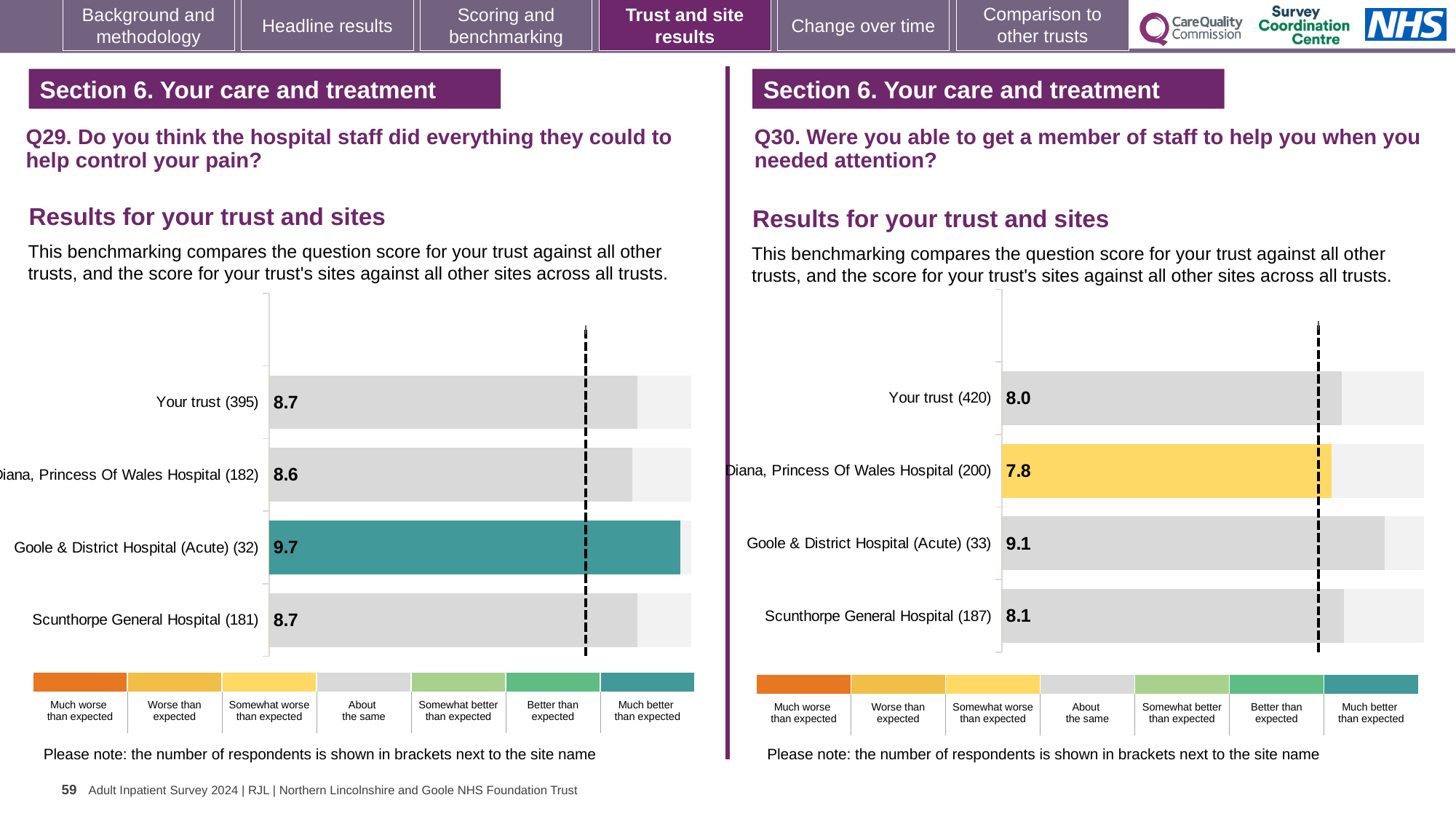
How many bars are plotted in the Q29 chart on the left? 4 In the Q30 chart on the right, how many respondents are shown in brackets for Your trust? 420 In the Q29 chart on the left, which site has the highest score? Goole & District Hospital (Acute) In the Q30 chart on the right, which has the higher score: Your trust or Scunthorpe General Hospital? Scunthorpe General Hospital What type of chart is used for the Q30 results on the right? Bar chart In the Q30 chart on the right, what is the difference between the scores for Goole & District Hospital (Acute) and Your trust? 1.1 In the Q29 chart on the left, what is the difference between the scores for Goole & District Hospital (Acute) and Diana, Princess Of Wales Hospital? 1.1 In the Q30 chart on the right, what is the score for Scunthorpe General Hospital? 8.1 In the Q29 chart on the left, what is the score for Your trust? 8.7 In the Q30 chart on the right, what is the score for Diana, Princess Of Wales Hospital? 7.8 In the Q30 chart on the right, which site has the lowest score? Diana, Princess Of Wales Hospital In the Q29 chart on the left, what is the score for Goole & District Hospital (Acute)? 9.7